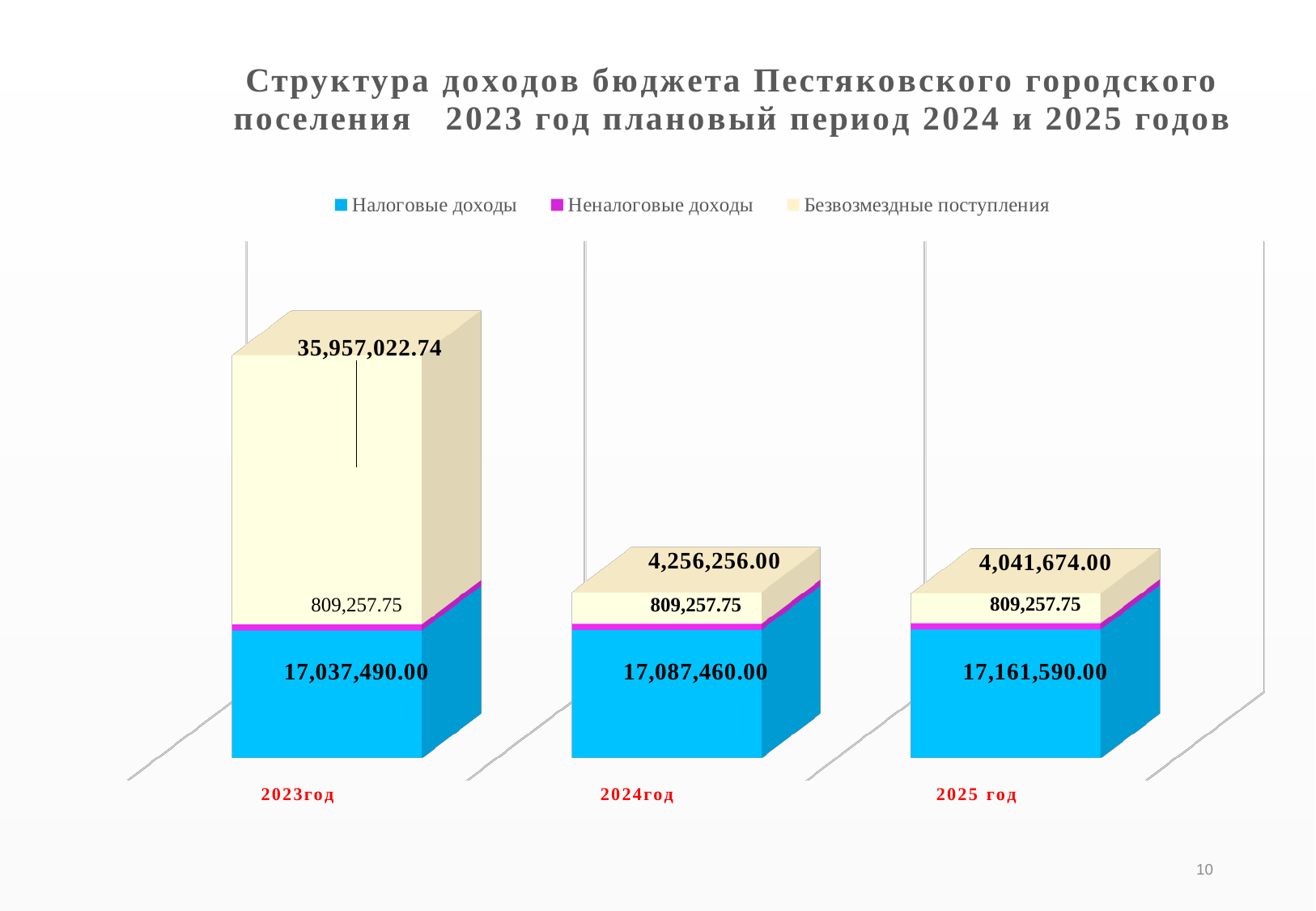
In which year is Налоговые доходы the lowest? 2023год What kind of chart is shown on the slide? Stacked bar chart What is the value of Неналоговые доходы for 2025 год? 809,257.75 Which is larger: Налоговые доходы in 2024год or Налоговые доходы in 2025 год? 2025 год In which year is Безвозмездные поступления the highest? 2023год How many series does the legend list? 3 What is the value of Налоговые доходы for 2025 год? 17,161,590.00 How many years are shown on the x axis? 3 What is the difference between Безвозмездные поступления in 2024год and 2025 год? 214,582.00 What is the value of Налоговые доходы for 2023год? 17,037,490.00 What is the value of Безвозмездные поступления for 2024год? 4,256,256.00 What is the total of the stacked bar for 2024год? 22,152,973.75